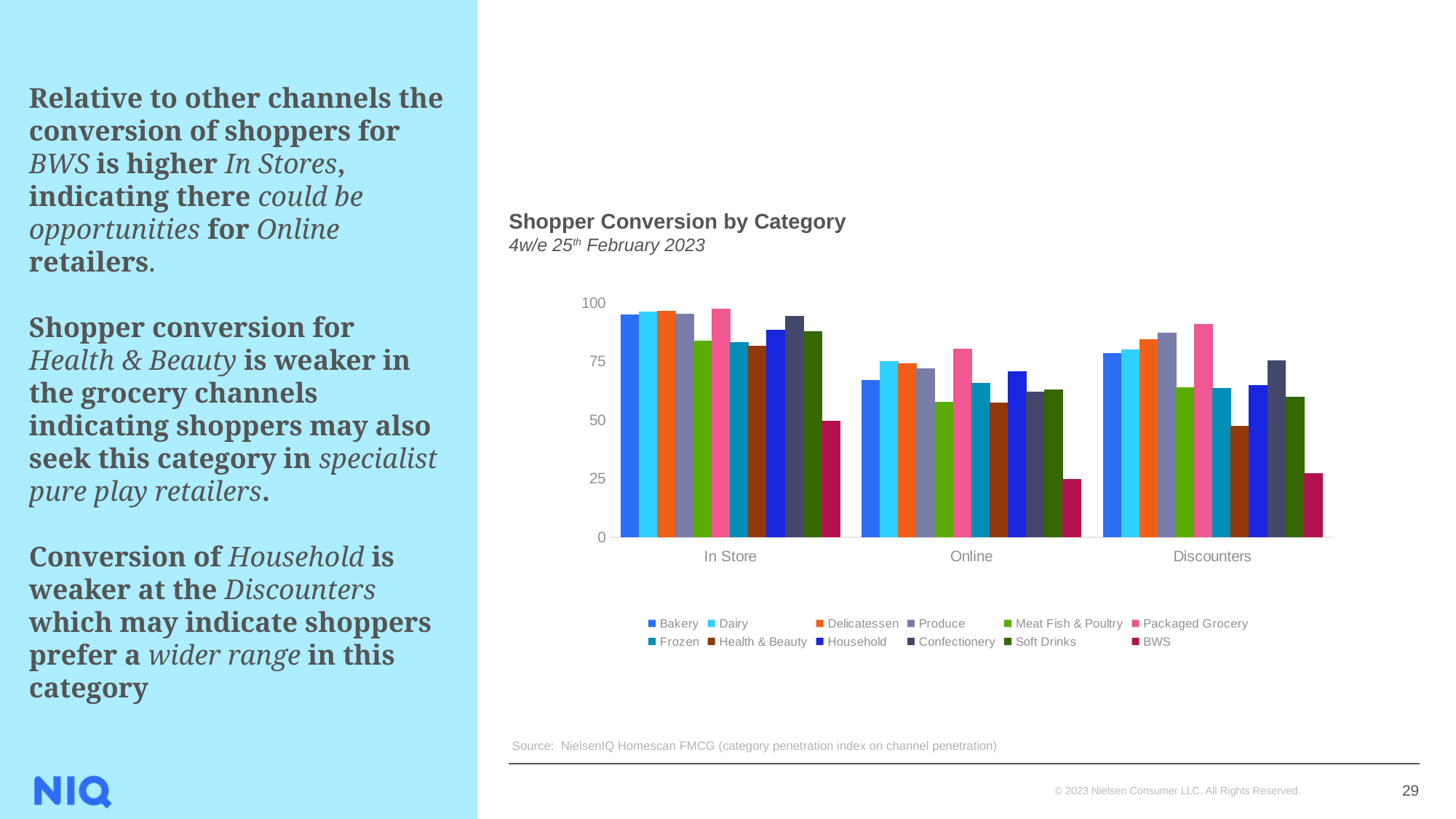
Is the value for Bakery in the Online group greater or less than 75? less Is the value for Packaged Grocery in the Online group greater or less than 75? greater How many channel categories are shown on the x axis of the chart? 3 How many series does the chart's legend list? 12 Which category has the lowest shopper conversion in the Discounters group? BWS Which category has the lowest shopper conversion in the In Store group? BWS What kind of chart is shown on the slide? bar chart Which is larger: the Packaged Grocery value Online or at Discounters? Discounters Which category has the highest shopper conversion in the Online group? Packaged Grocery What is the title of the chart? Shopper Conversion by Category Which is larger: the BWS value In Store or the BWS value Online? In Store Is the value for Health & Beauty at Discounters greater or less than 50? less